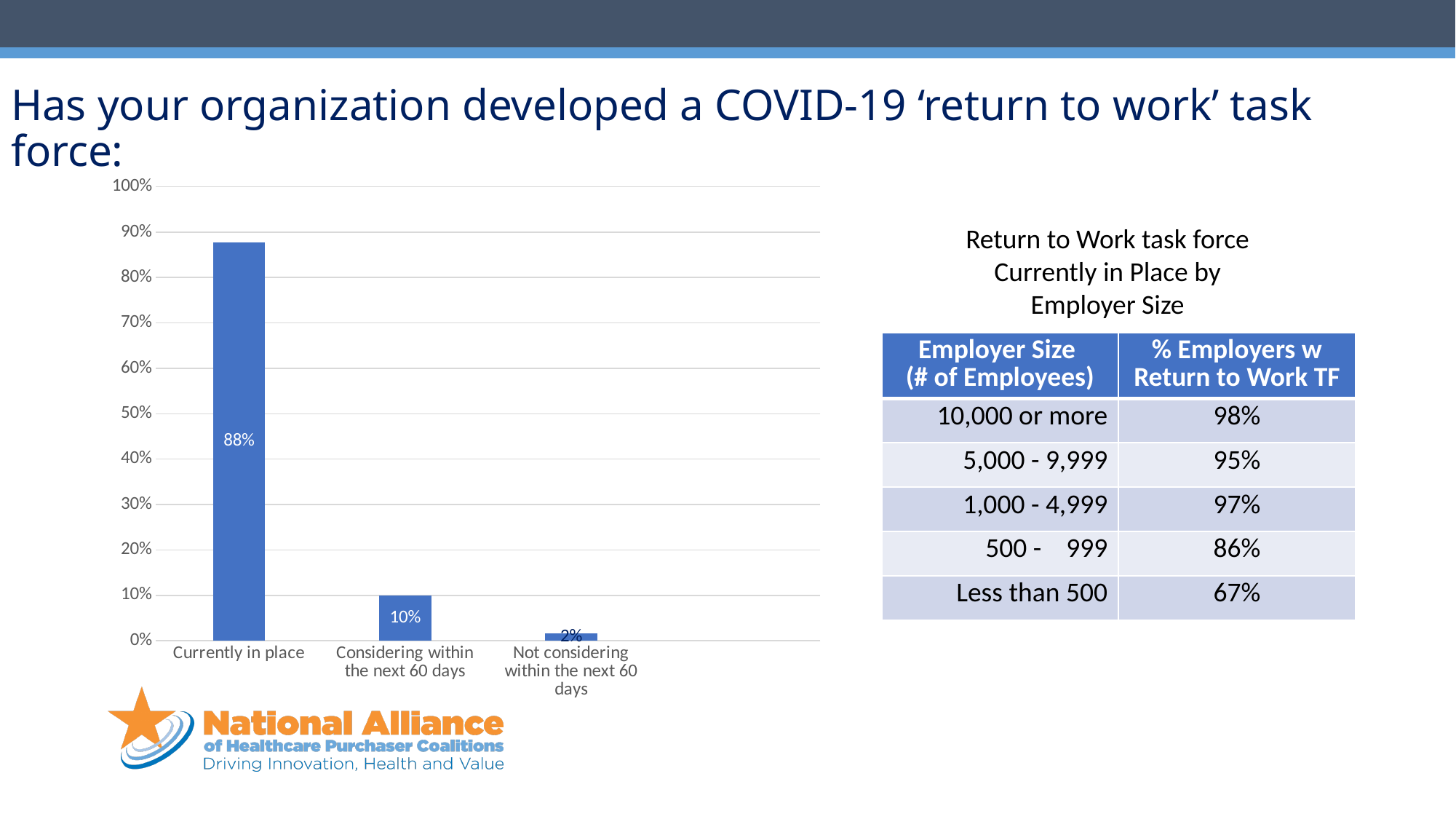
How many categories are shown on the x axis of the bar chart? 3 Do the values rise or fall moving from left to right along the x axis? Fall What is the difference between the 'Currently in place' value and the 'Considering within the next 60 days' value? 78% Is the value for 'Currently in place' greater or less than 80%? greater What percentage of organizations currently have a COVID-19 'return to work' task force in place? 88% What kind of chart is shown on the slide? Bar chart Which category has the highest value in the bar chart? Currently in place What is the value for 'Not considering within the next 60 days'? 2% Which is larger: the value for 'Considering within the next 60 days' or 'Not considering within the next 60 days'? Considering within the next 60 days What is the maximum value shown on the y axis of the bar chart? 100% Which category has the lowest value in the bar chart? Not considering within the next 60 days What is the value for 'Considering within the next 60 days'? 10%